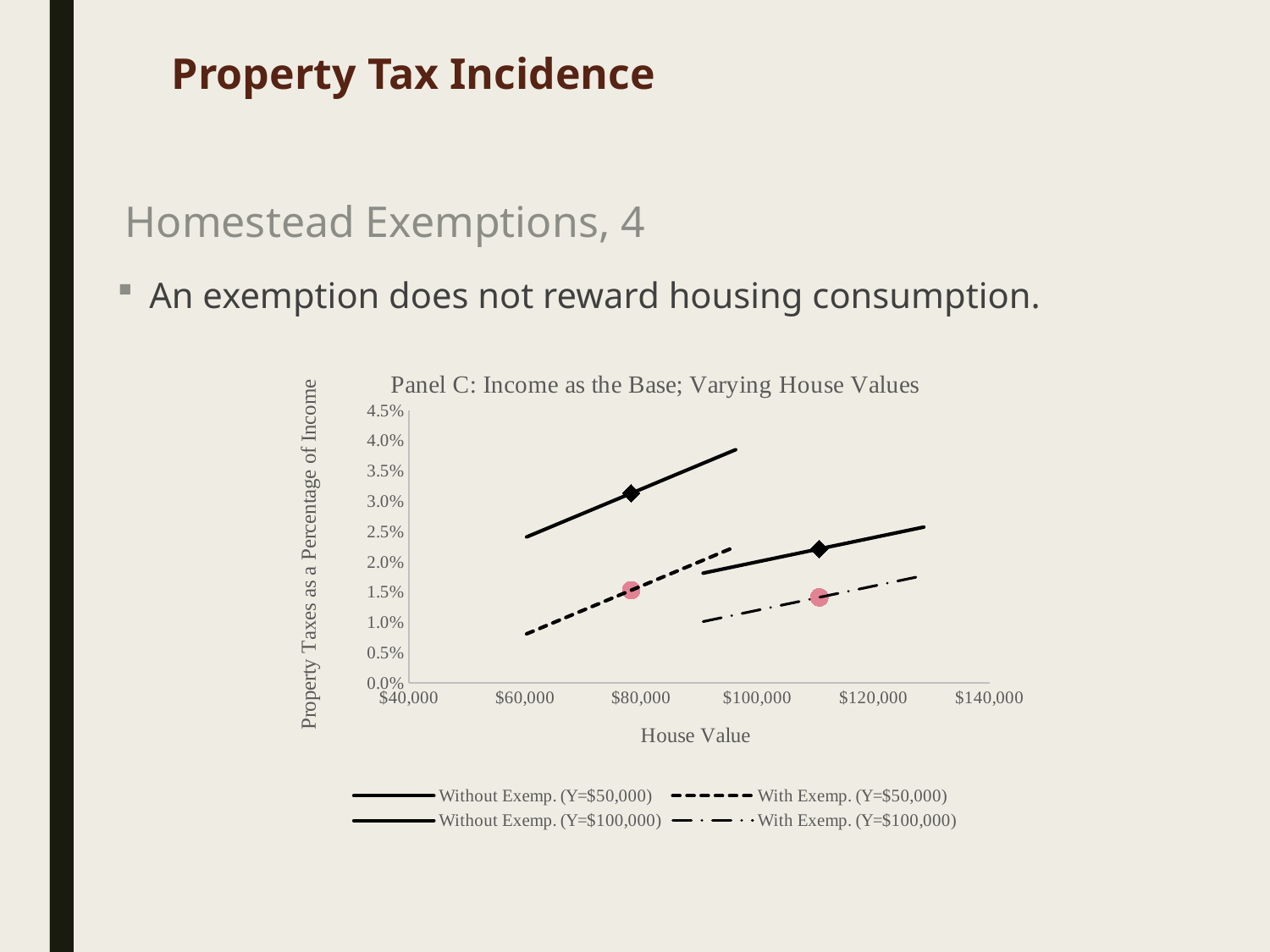
What kind of chart is shown on the slide? Line chart Is the value for With Exemp. (Y=$100,000) at a house value of $110,000 greater or less than 1.0%? greater What is the label of the vertical axis of the chart? Property Taxes as a Percentage of Income Is the value for With Exemp. (Y=$50,000) at a house value of $60,000 greater or less than 1.0%? less Is the value for Without Exemp. (Y=$50,000) at a house value of $60,000 greater or less than 3.0%? less At a house value of $80,000, which series has the larger value: Without Exemp. (Y=$50,000) or With Exemp. (Y=$50,000)? Without Exemp. (Y=$50,000) What is the title of the chart? Panel C: Income as the Base; Varying House Values How many series does the chart's legend list? 4 Do the values of the Without Exemp. (Y=$50,000) series rise or fall as house value increases? Rise Do the values of the With Exemp. (Y=$100,000) series rise or fall as house value increases? Rise